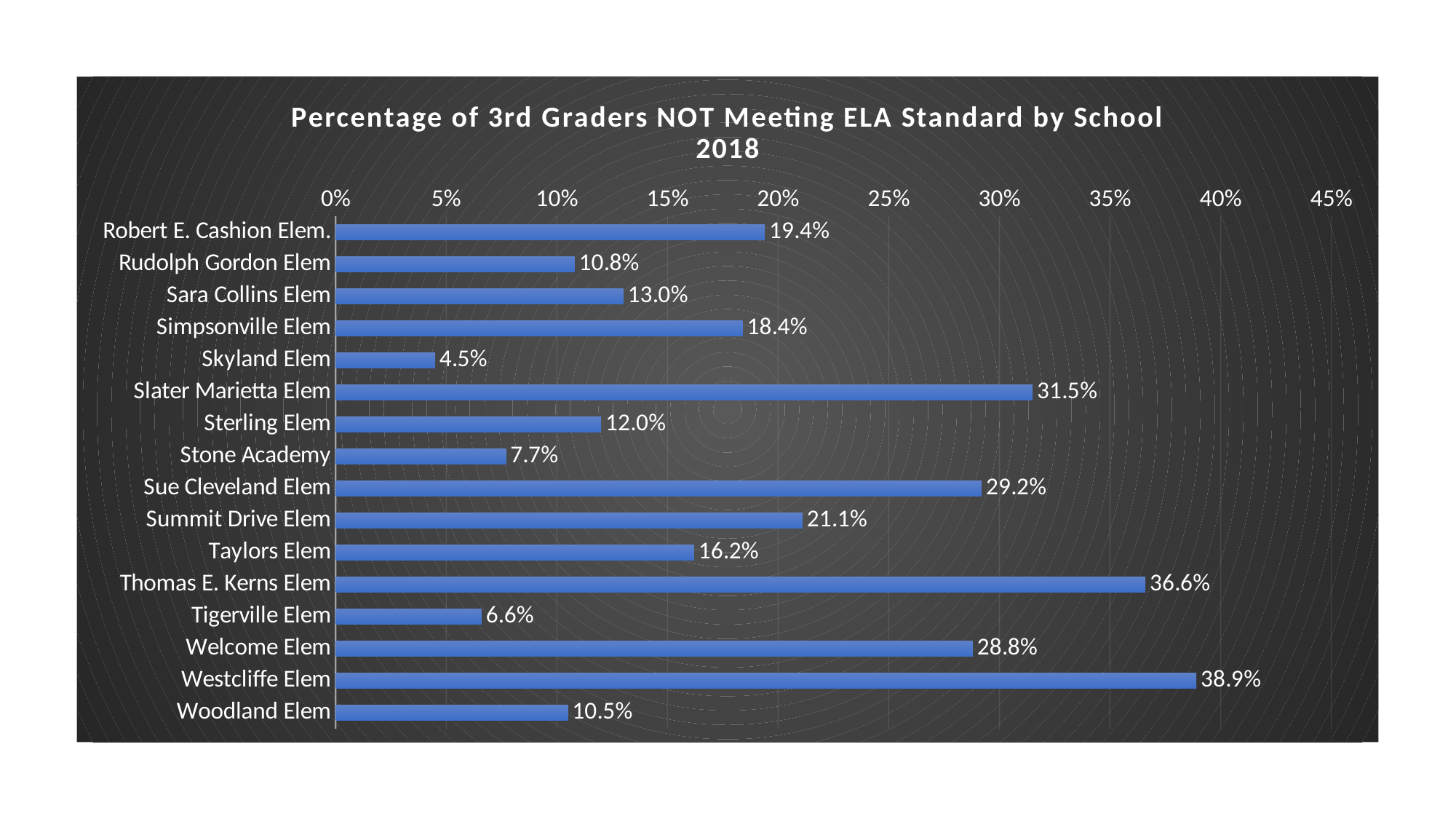
What is the value shown for Woodland Elem? 10.5% Is the value for Simpsonville Elem greater or less than 20%? less What is the value shown for Stone Academy? 7.7% What kind of chart is shown on the slide? Bar chart What is the difference between the values for Thomas E. Kerns Elem and Tigerville Elem? 30.0% What is the difference between the values for Sue Cleveland Elem and Welcome Elem? 0.4% What percentage of 3rd graders did not meet the ELA standard at Slater Marietta Elem? 31.5% What is the title of the chart? Percentage of 3rd Graders NOT Meeting ELA Standard by School 2018 How many schools are shown in the chart? 16 Which has a higher value, Summit Drive Elem or Taylors Elem? Summit Drive Elem Which school has the highest percentage of 3rd graders not meeting the ELA standard? Westcliffe Elem Which school has the lowest percentage of 3rd graders not meeting the ELA standard? Skyland Elem